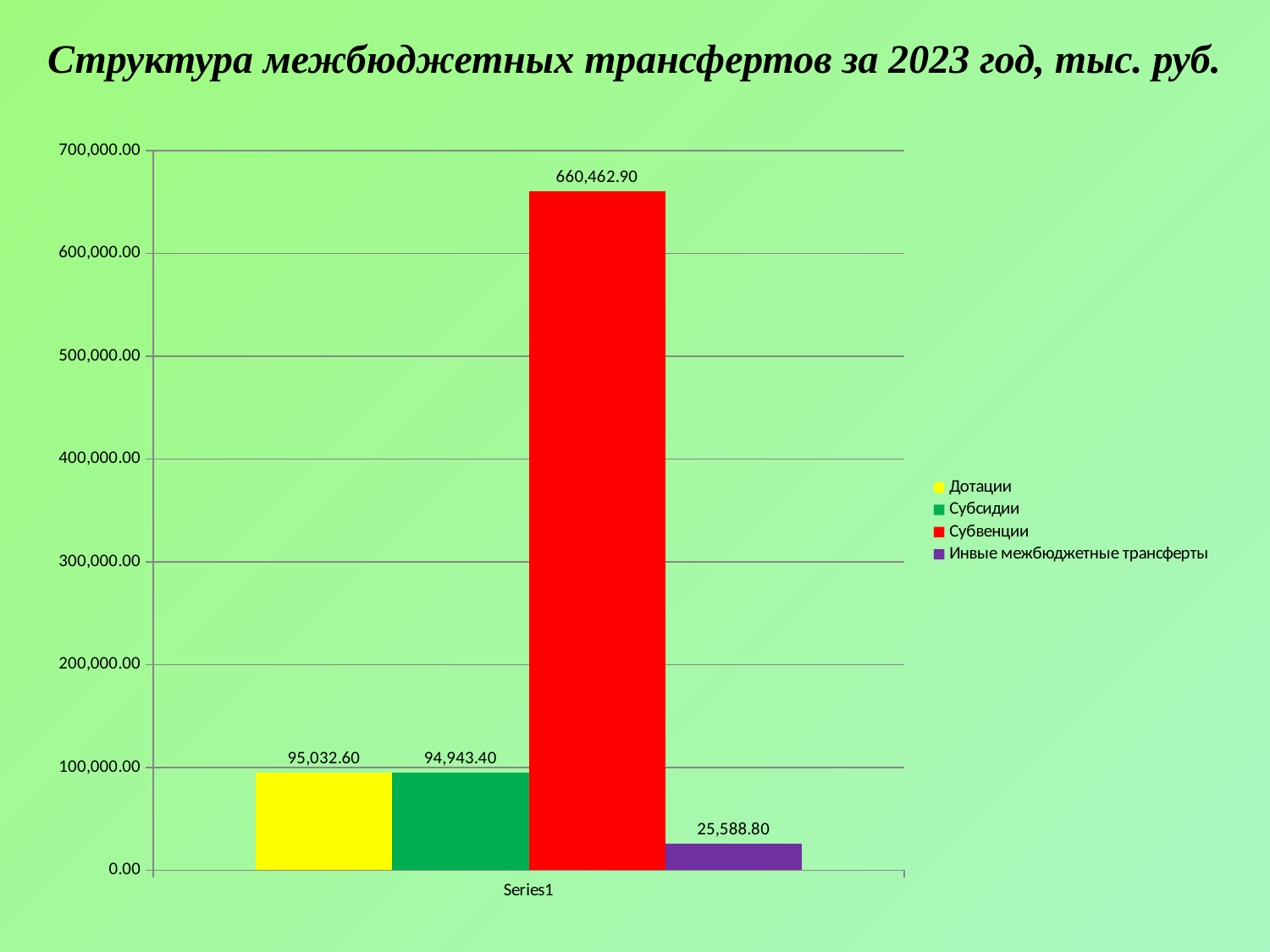
What is the difference between the values for Субвенции and Инвые межбюджетные трансферты? 634,874.10 Which is larger, the value for Субвенции or the value for Дотации? Субвенции What is the value for Инвые межбюджетные трансферты? 25,588.80 How many series does the legend list? 4 What kind of chart is shown on the slide? bar chart Is the value for Субвенции greater or less than 600,000.00? greater Which category has the lowest value? Инвые межбюджетные трансферты Which category has the highest value? Субвенции What is the value for Субвенции? 660,462.90 What is the difference between the values for Дотации and Субсидии? 89.20 What is the value for Субсидии? 94,943.40 What is the value for Дотации? 95,032.60